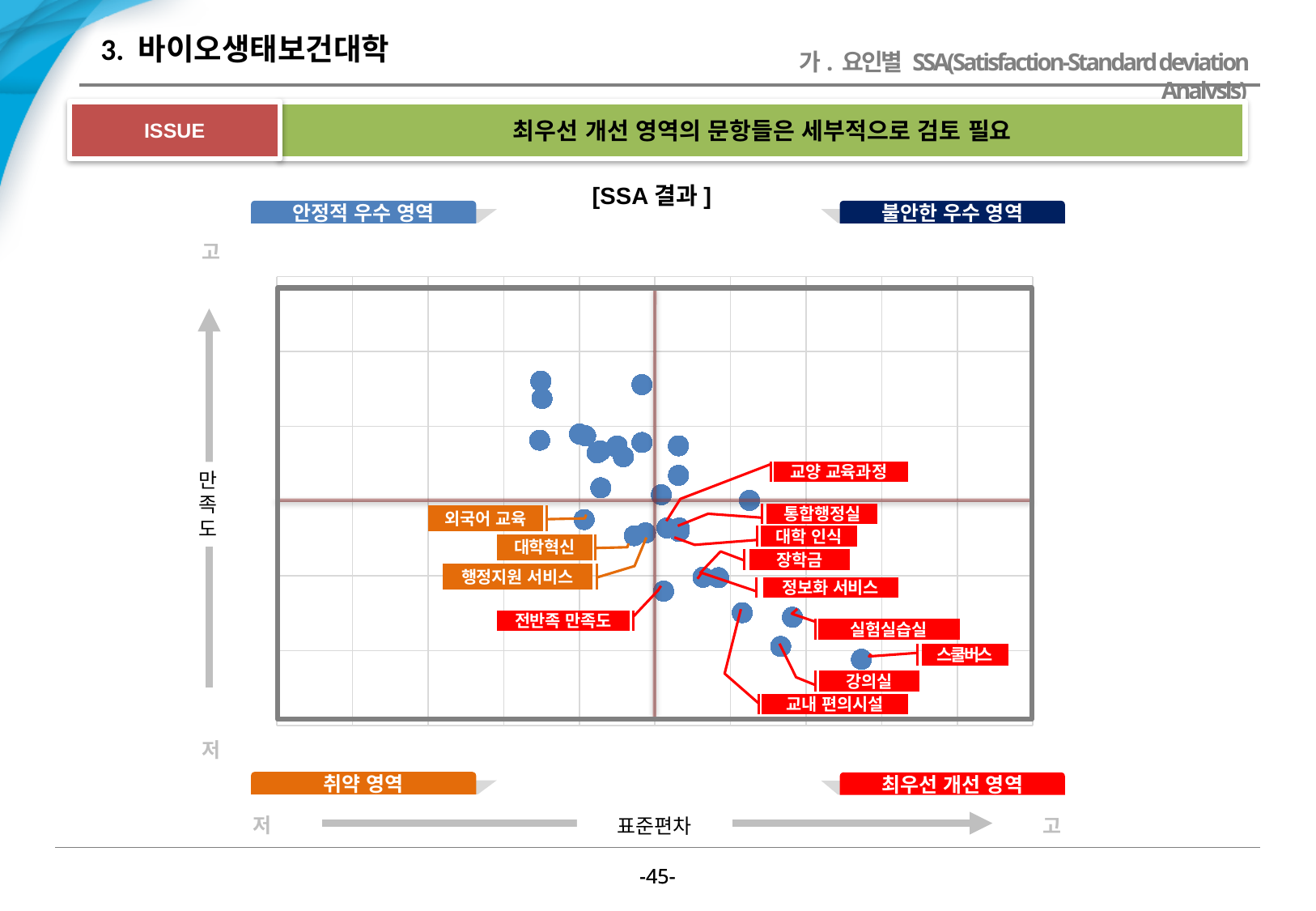
Which labeled point on the SSA chart has the lowest standard deviation (furthest left)? 외국어 교육 What kind of chart is shown under the title [SSA 결과 ]? Scatter chart Which labeled point on the SSA chart has the highest standard deviation (furthest right)? 스쿨버스 How many data points on the SSA chart have a text label attached? 13 On the SSA chart, which has the higher satisfaction: 교양 교육과정 or 스쿨버스? 교양 교육과정 What is the label of the vertical axis of the SSA chart? 만족도 On the SSA chart, which has the higher satisfaction: 전반족 만족도 or 강의실? 전반족 만족도 In which quadrant region of the SSA chart does the point 스쿨버스 fall? 최우선 개선 영역 What is the label of the horizontal axis of the SSA chart? 표준편차 How many data points on the SSA chart are marked with orange labels? 3 How many data points on the SSA chart are marked with red labels? 10 On the SSA chart, which has the larger standard deviation: 외국어 교육 or 실험실습실? 실험실습실